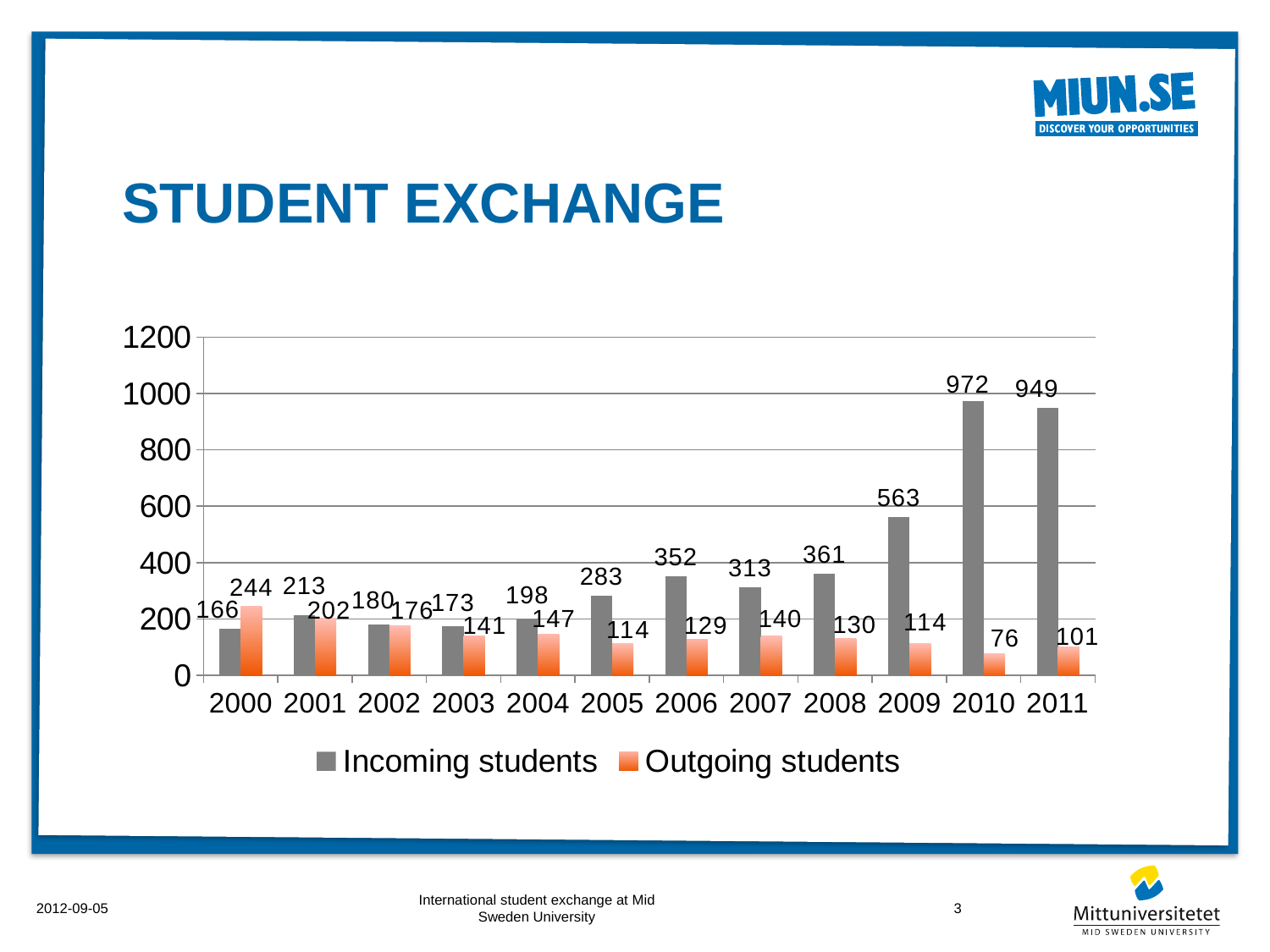
In which year was the number of outgoing students lowest? 2010 How many incoming students were there in 2010? 972 How many series does the legend list? 2 How many outgoing students were there in 2003? 141 What is the difference between incoming and outgoing students in 2011? 848 Is the number of incoming students in 2009 greater or less than 400? greater Did the number of incoming students rise or fall from 2005 to 2010? Rise How many years are shown on the x axis? 12 Which was larger in 2000, incoming students or outgoing students? Outgoing students In which year was the number of incoming students highest? 2010 Which colour represents outgoing students in the chart? Orange What kind of chart is shown on the slide? Bar chart